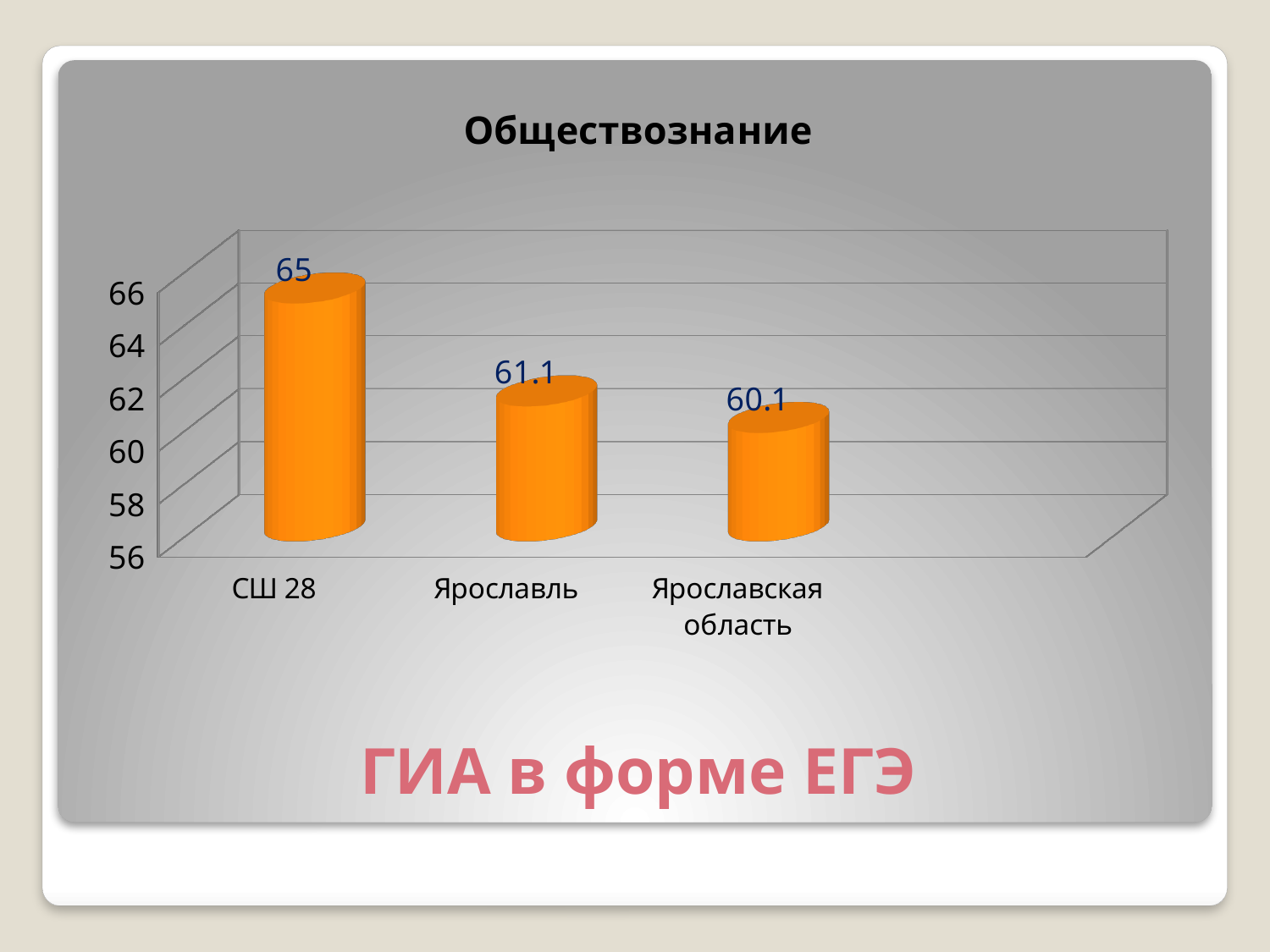
How many categories are shown in the chart? 3 Which category has the highest value? СШ 28 What is the title of the chart? Обществознание What is the difference between the values for СШ 28 and Ярославль? 3.9 What is the value for Ярославль? 61.1 What is the value for Ярославская область? 60.1 Which category has the lowest value? Ярославская область What is the difference between the values for Ярославль and Ярославская область? 1 What is the value for СШ 28? 65 What kind of chart is shown on the slide? bar chart Which is larger, the value for Ярославль or the value for Ярославская область? Ярославль Is the value for СШ 28 greater or less than 64? greater